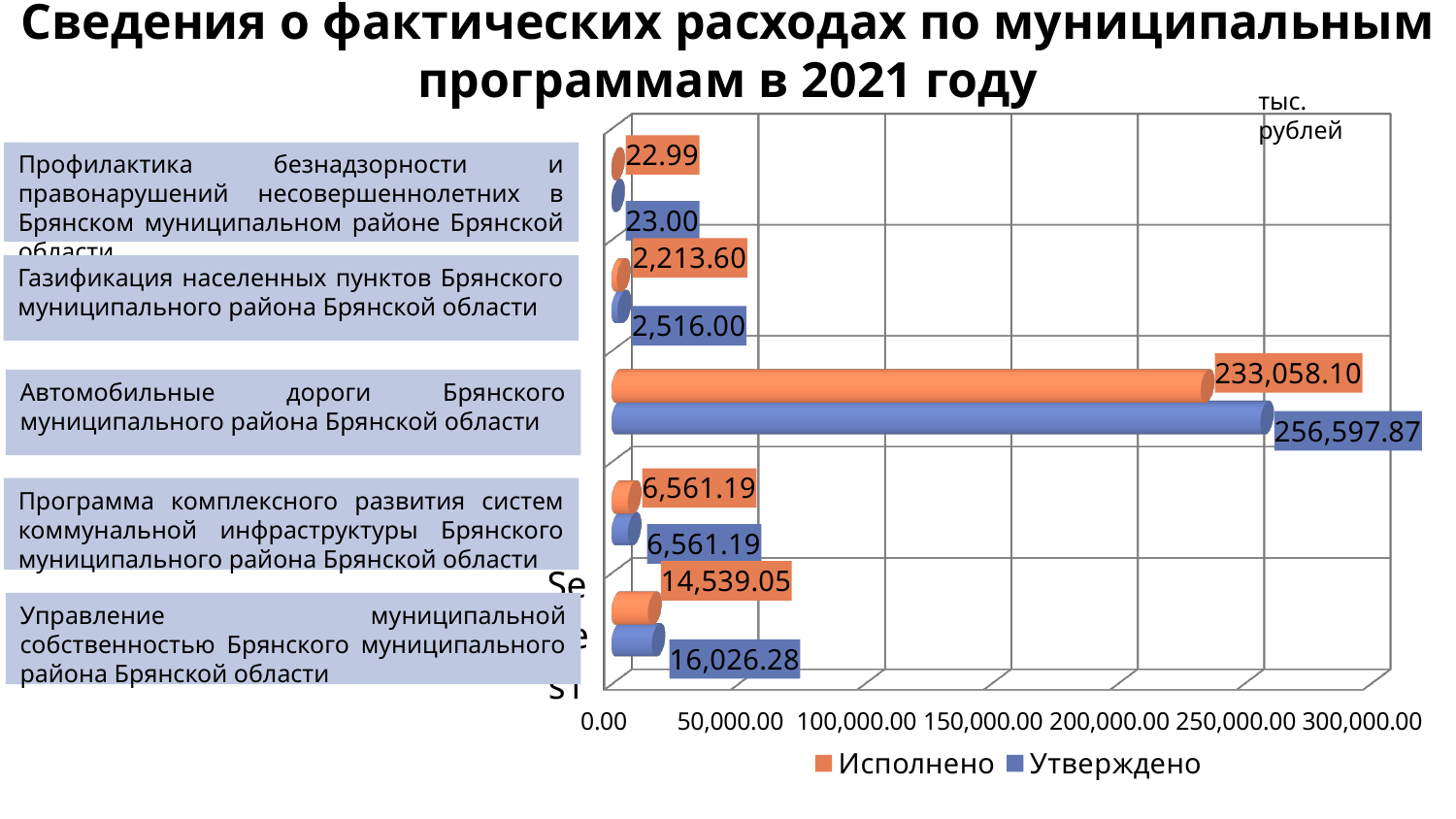
Which program has the highest Утверждено value? Автомобильные дороги Брянского муниципального района Брянской области What is the Исполнено value for Автомобильные дороги Брянского муниципального района Брянской области? 233,058.10 What is the Утверждено value for Газификация населенных пунктов Брянского муниципального района Брянской области? 2,516.00 How many series does the legend list? 2 What is the Исполнено value for Управление муниципальной собственностью Брянского муниципального района Брянской области? 14,539.05 What is the difference between the Утверждено and Исполнено values for Управление муниципальной собственностью Брянского муниципального района Брянской области? 1,487.23 For Газификация населенных пунктов Брянского муниципального района Брянской области, which is larger: Исполнено or Утверждено? Утверждено How many programs (categories) are shown in the chart? 5 What type of chart is shown on the slide? bar chart What is the Утверждено value for Автомобильные дороги Брянского муниципального района Брянской области? 256,597.87 What unit is indicated in the top right corner of the chart? тыс. рублей Which program has the lowest Исполнено value? Профилактика безнадзорности и правонарушений несовершеннолетних в Брянском муниципальном районе Брянской области